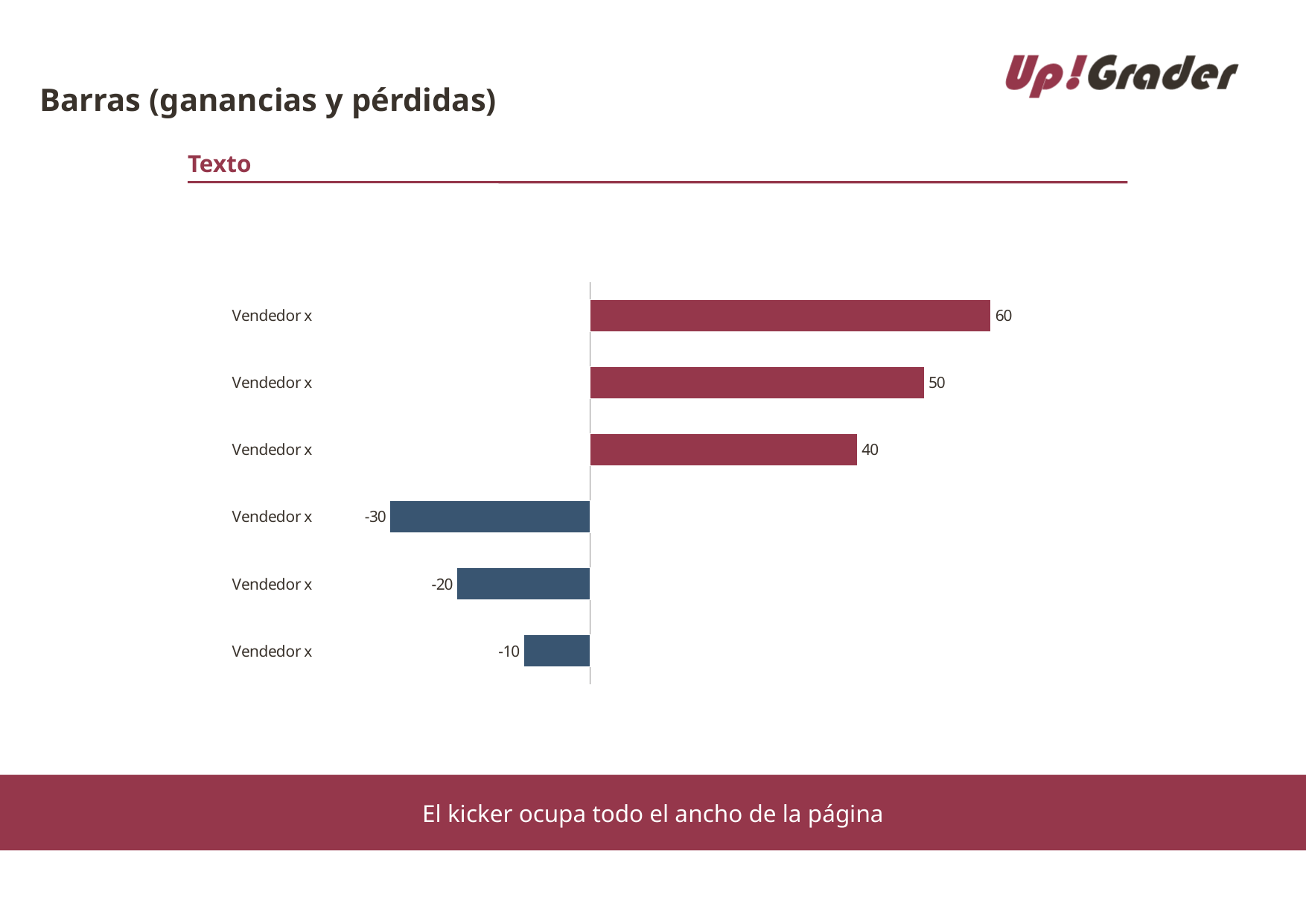
What is the lowest value shown in the chart? -30 Do the bar values rise or fall going from the top of the chart to the bottom? fall What colour are the bars with negative values? dark blue What is the value of the topmost bar in the chart? 60 How many bars does the chart contain? 6 What is the value of the third bar from the top? 40 Which is larger, the second bar from the top or the third bar from the top? the second bar from the top (50) What is the value of the bottommost bar in the chart? -10 How many bars in the chart have negative values? 3 What is the difference between the topmost bar (60) and the bottommost bar (-10)? 70 What is the highest value shown in the chart? 60 What kind of chart is shown on the slide? bar chart